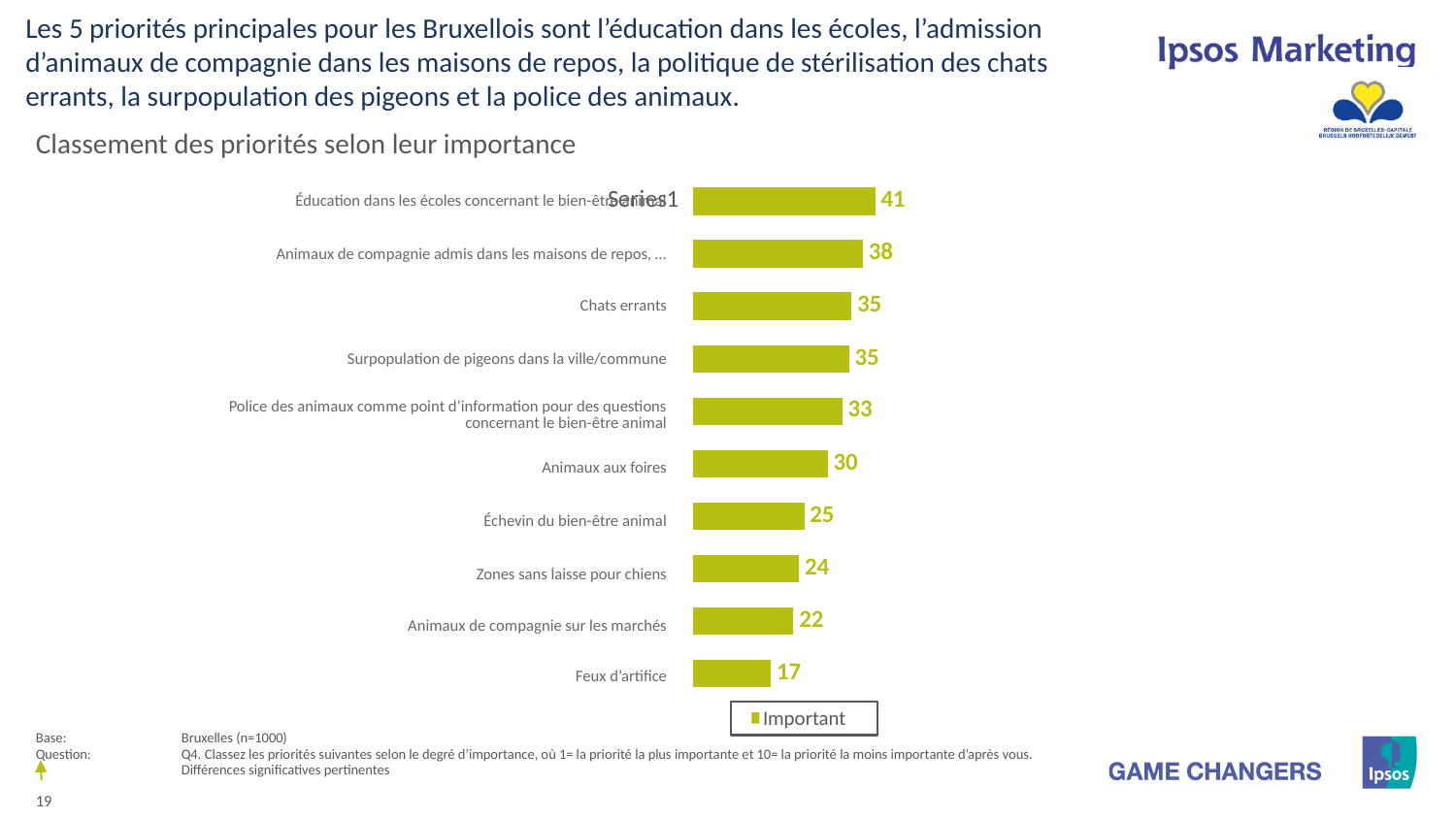
What value is shown for "Chats errants"? 35 What value is shown for "Animaux aux foires"? 30 Which category has the highest value in the chart? Éducation dans les écoles concernant le bien-être... Which category has the lowest value in the chart? Feux d'artifice Which has a larger value: "Échevin du bien-être animal" or "Animaux aux foires"? Animaux aux foires What value is shown for "Feux d'artifice"? 17 What kind of chart is shown on the slide? Bar chart What is the difference between the values for "Animaux de compagnie admis dans les maisons de repos, …" and "Animaux de compagnie sur les marchés"? 16 What is the legend entry shown below the chart? Important What value is shown for "Zones sans laisse pour chiens"? 24 How many categories are shown in the chart? 10 How many series does the legend list? 1